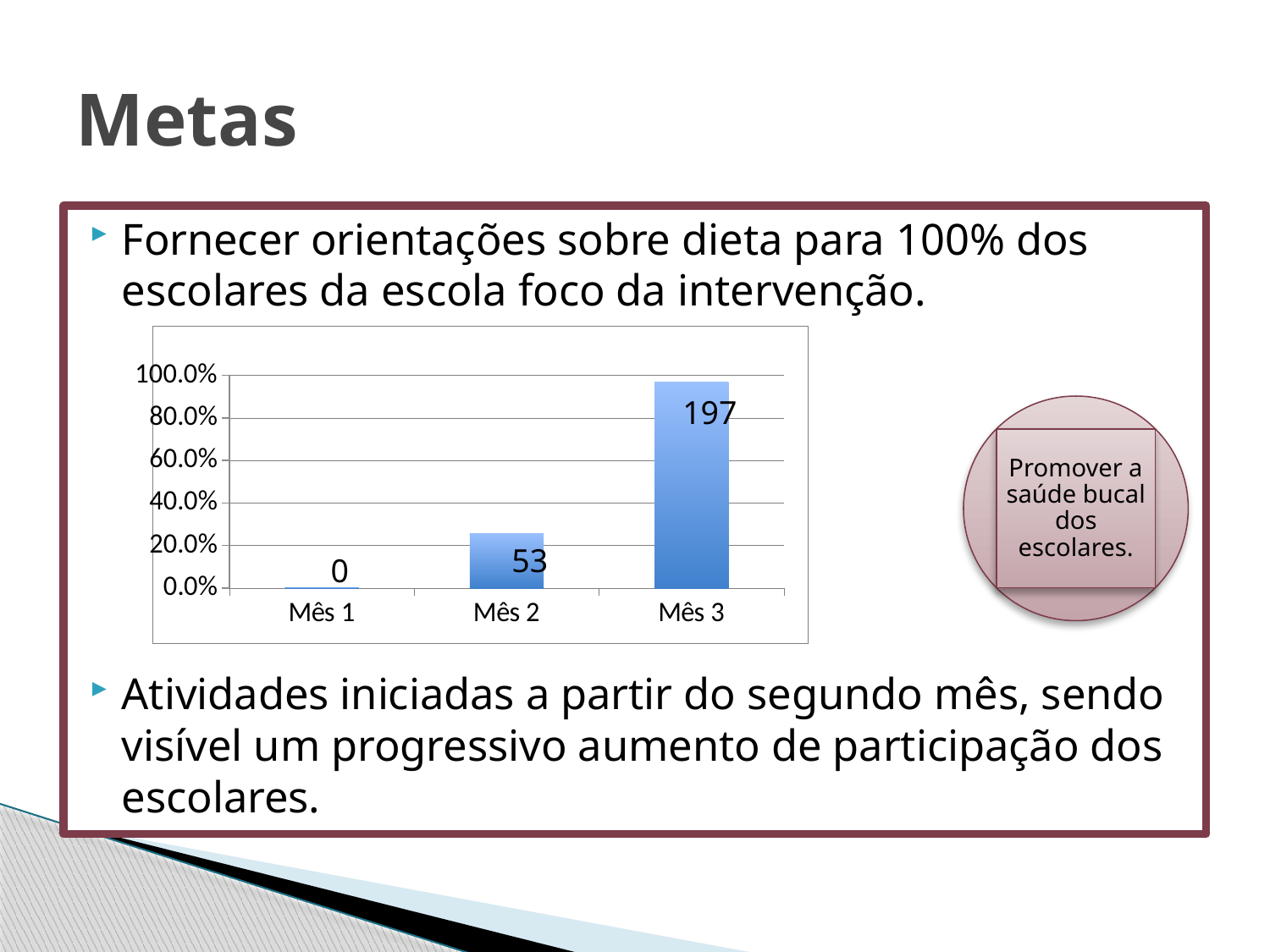
What kind of chart is shown on the slide? bar chart Is the bar for Mês 2 greater or less than 40.0% on the y axis? less Do the values rise or fall from Mês 1 to Mês 3? rise What is the data label shown on the bar for Mês 3? 197 Is the bar for Mês 3 greater or less than 80.0% on the y axis? greater Which month has the lowest bar in the chart? Mês 1 Which is larger, the value for Mês 2 or the value for Mês 3? Mês 3 Which month has the highest bar in the chart? Mês 3 What is the data label shown on the bar for Mês 1? 0 How many categories are shown on the x axis of the chart? 3 What is the data label shown on the bar for Mês 2? 53 What is the difference between the data labels for Mês 3 and Mês 2? 144